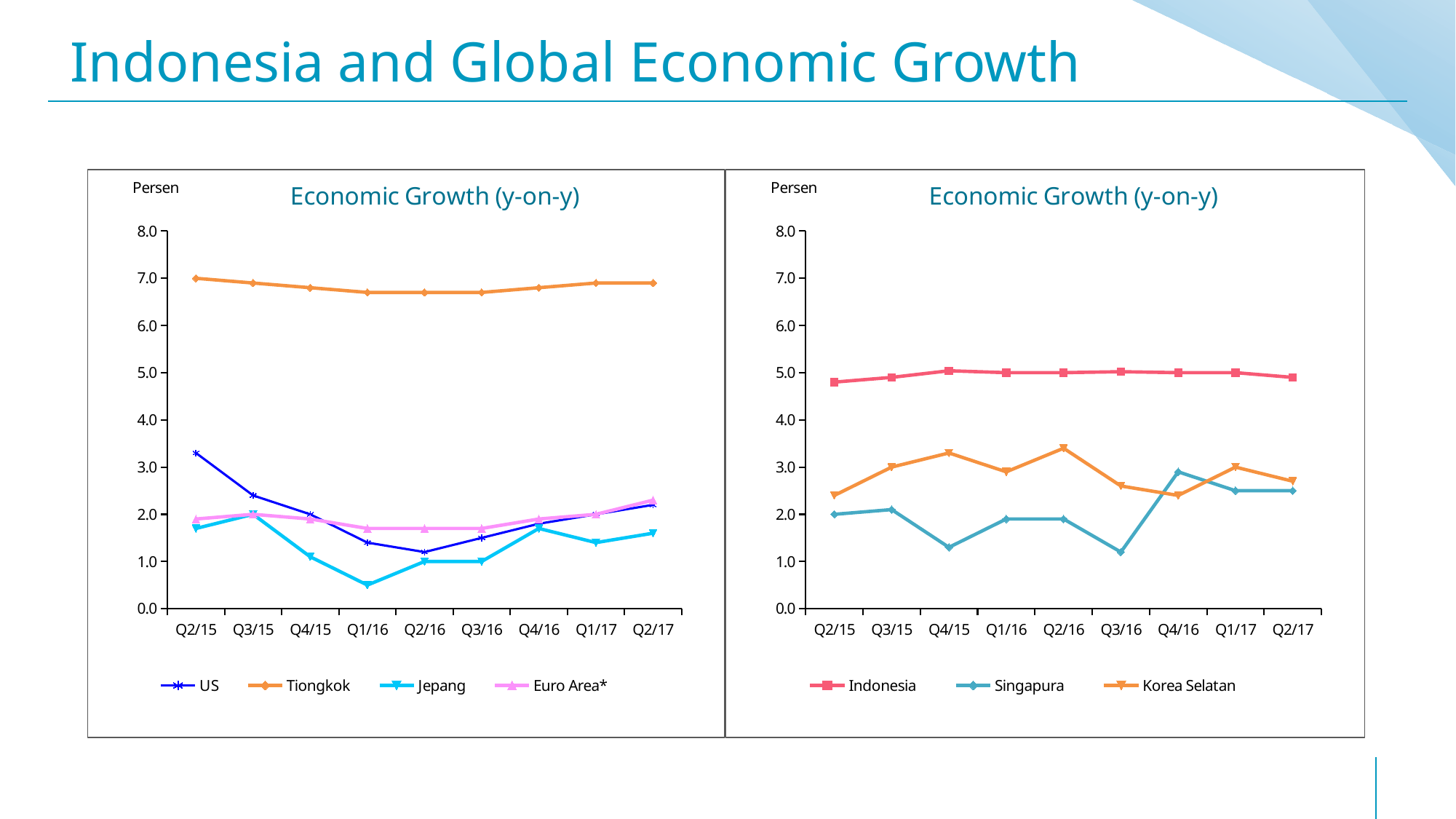
In the left chart, which series has the lowest value at Q1/16? Jepang What kind of chart is the left chart? line chart In the left chart, is the value for Jepang at Q1/16 greater or less than 1.0? less How many series does the legend of the right chart list? 3 How many series does the legend of the left chart list? 4 In the right chart, which series has the highest values across all quarters? Indonesia In the right chart, at Q4/16, which is larger: Singapura or Korea Selatan? Singapura In the left chart, is the value for Tiongkok at Q1/16 greater or less than 7.0? less In the left chart, which series has the highest values across all quarters? Tiongkok How many quarters are plotted along the x axis of the right chart? 9 In the left chart, does the US line rise or fall from Q2/15 to Q2/16? fall In the left chart, is the value for US at Q2/15 greater or less than 3.0? greater